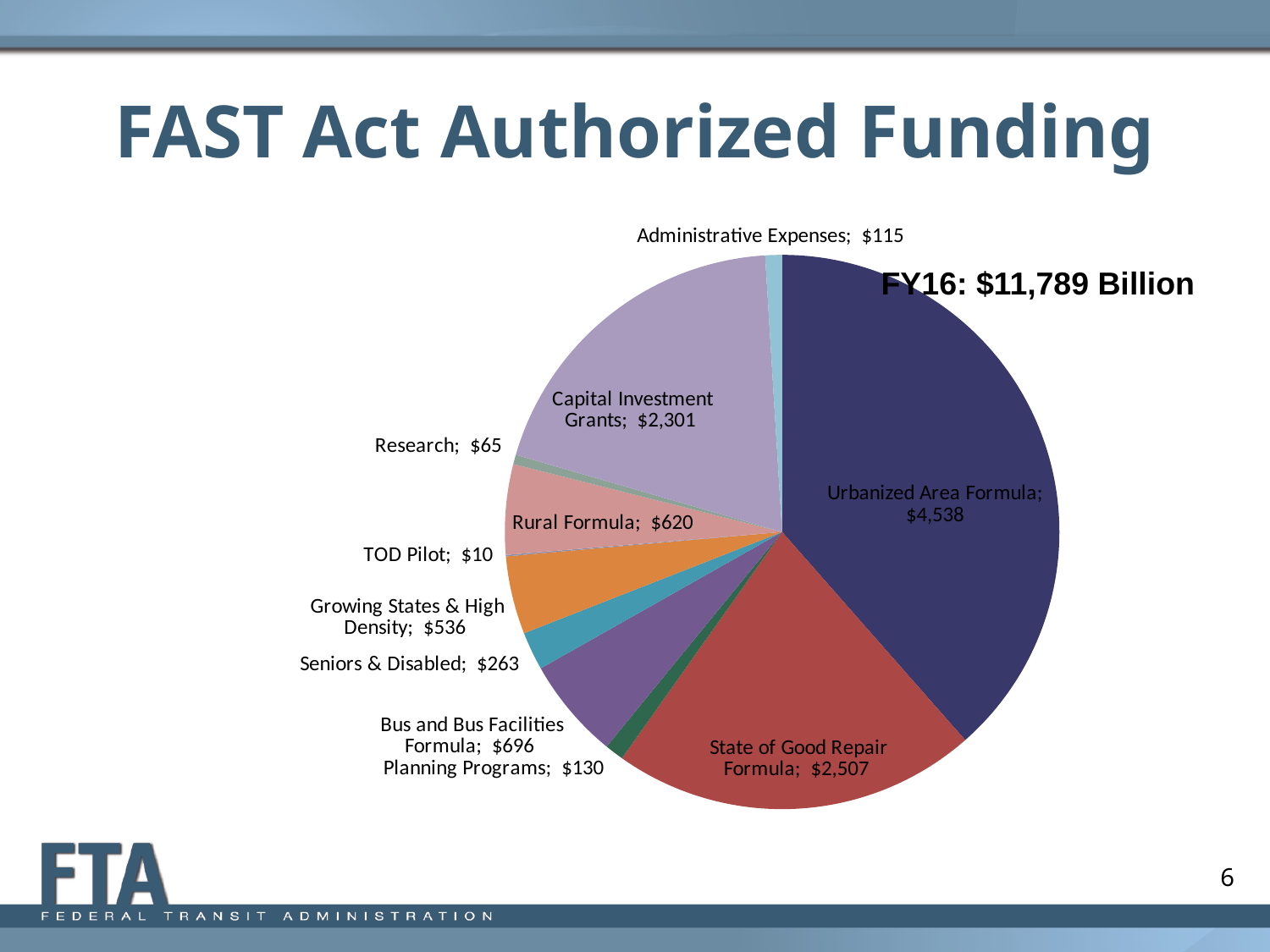
What FY16 total is stated next to the pie chart? $11,789 Billion What is the difference between Bus and Bus Facilities Formula and Seniors & Disabled? $433 Which category has the largest slice of the pie? Urbanized Area Formula What is the value for Seniors & Disabled? $263 What kind of chart is shown on the slide? pie chart Which category has the smallest slice of the pie? TOD Pilot What is the value for Urbanized Area Formula? $4,538 What is the difference between Urbanized Area Formula and State of Good Repair Formula? $2,031 How many categories are shown in the pie chart? 11 What is the value for Capital Investment Grants? $2,301 Which is larger, State of Good Repair Formula or Capital Investment Grants? State of Good Repair Formula What is the value for TOD Pilot? $10